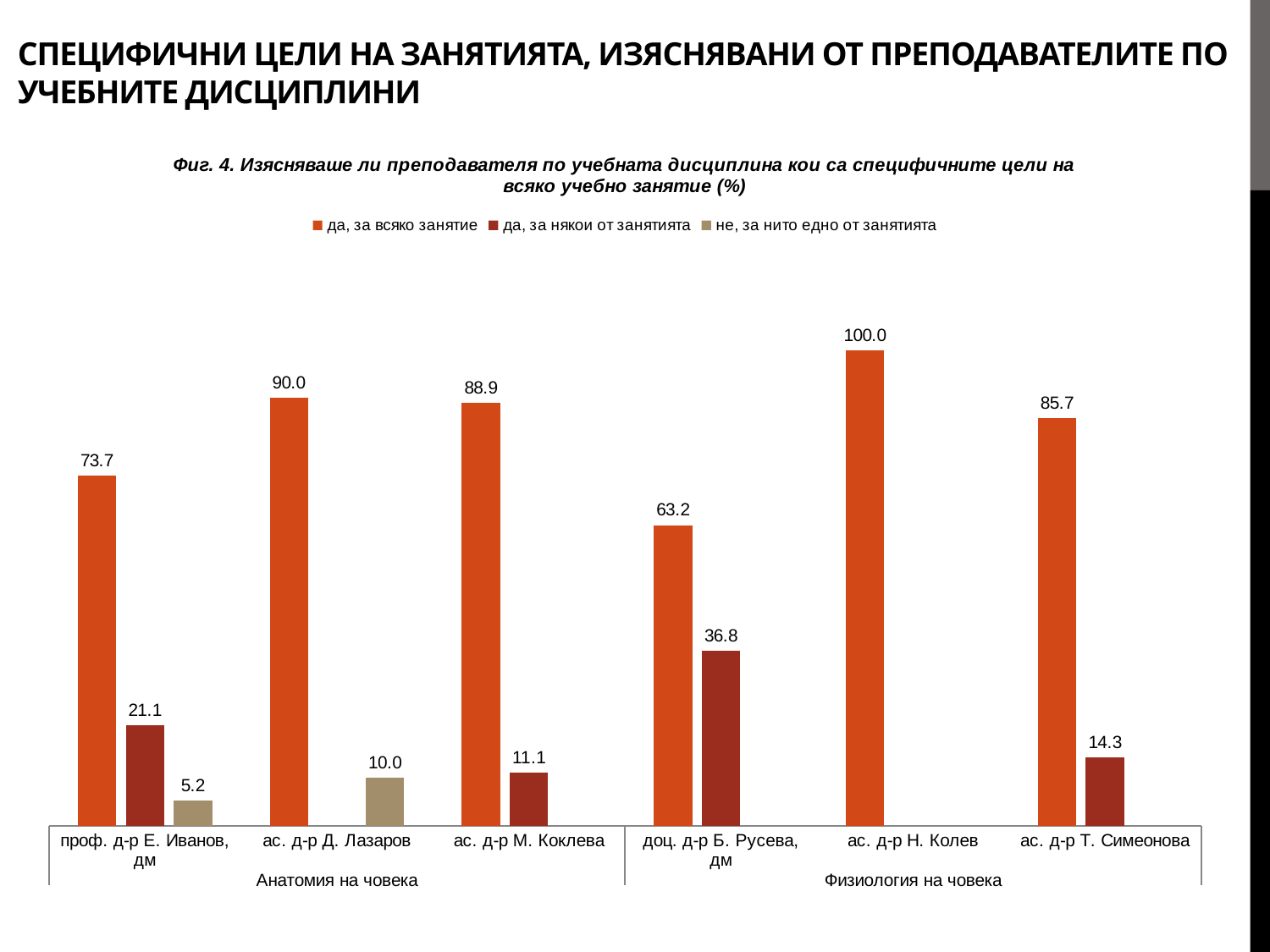
Which two disciplines are the lecturers grouped under on the x axis? Анатомия на човека and Физиология на човека Which lecturer has the highest value for "да, за всяко занятие"? ас. д-р Н. Колев What is the value of "да, за всяко занятие" for ас. д-р Т. Симеонова? 85.7 What is the difference between the "да, за всяко занятие" values for ас. д-р Д. Лазаров and проф. д-р Е. Иванов, дм? 16.3 What kind of chart is shown? bar chart How many lecturers are shown on the x axis? 6 Which lecturer has the lowest value for "да, за всяко занятие"? доц. д-р Б. Русева, дм What is the value of "не, за нито едно от занятията" for проф. д-р Е. Иванов, дм? 5.2 How many series does the legend list? 3 What is the value of "да, за някои от занятията" for доц. д-р Б. Русева, дм? 36.8 Which is larger: the "да, за някои от занятията" value for проф. д-р Е. Иванов, дм or for ас. д-р Т. Симеонова? проф. д-р Е. Иванов, дм What is the value of "да, за всяко занятие" for ас. д-р Н. Колев? 100.0